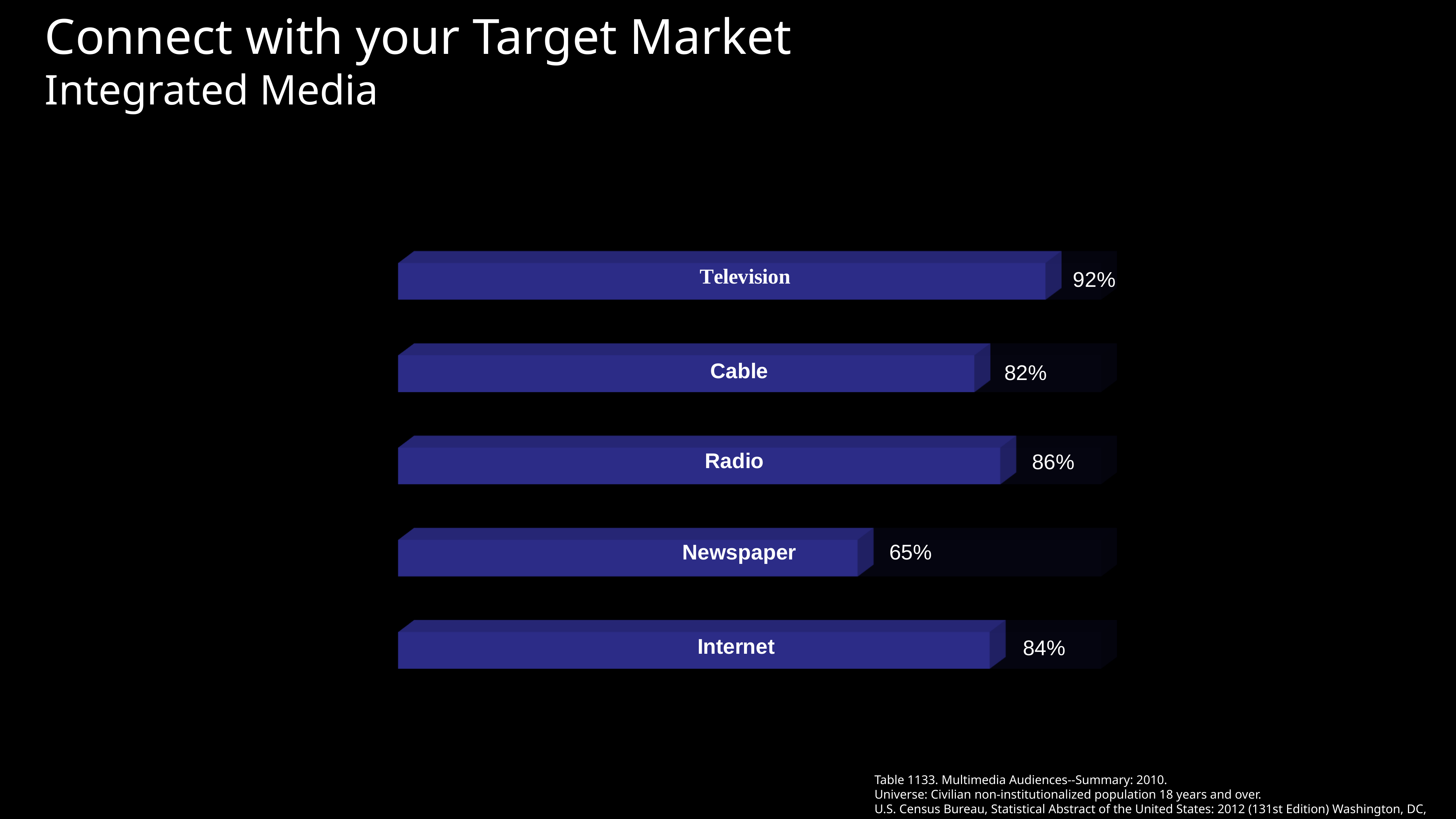
What is the value for Internet? 84% How many categories are shown in the chart? 5 What is the value for Cable? 82% Which category has the lowest value? Newspaper Which is larger, the value for Internet or the value for Cable? Internet What is the value for Newspaper? 65% Which category has the highest value? Television What is the value for Radio? 86% What is the difference between the values for Television and Newspaper? 27% What is the difference between the values for Radio and Cable? 4% What is the value for Television? 92% What kind of chart is shown on the slide? Bar chart